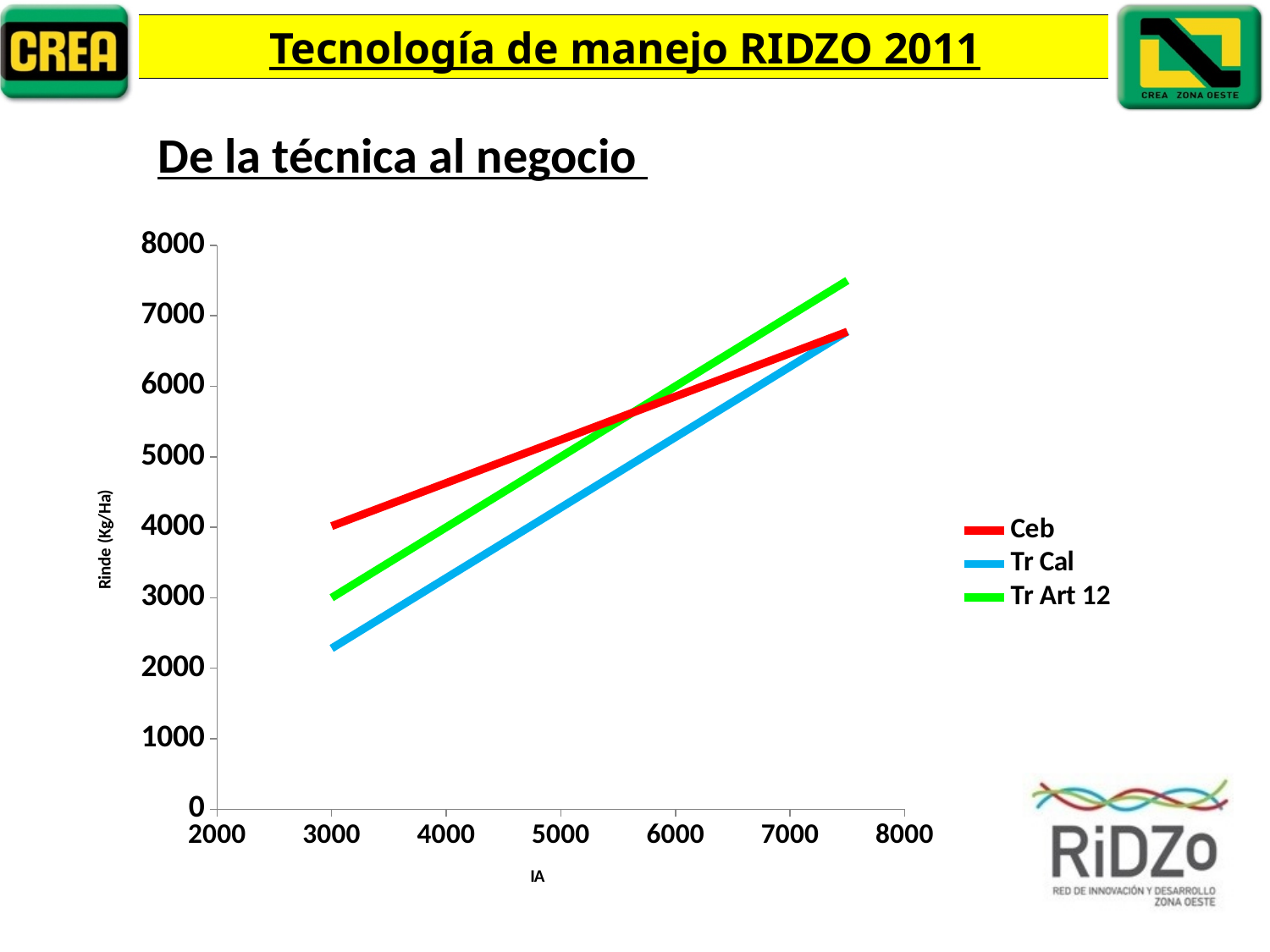
Is the value for Tr Cal at IA 3000 greater or less than 3000? less Do the values for Tr Cal rise or fall as IA increases? rise Which series has the highest value at IA 3000? Ceb Is the value for Ceb at IA 3000 greater or less than 3000? greater Which series is drawn in red? Ceb Do the values for Ceb rise or fall as IA increases? rise What is the title of the vertical axis? Rinde (Kg/Ha) How many series does the legend list? 3 Which series has the lowest value at IA 3000? Tr Cal Is the value for Tr Art 12 at IA 7500 greater or less than 7000? greater Which series has the highest value at IA 7500? Tr Art 12 What kind of chart is shown on the slide? line chart